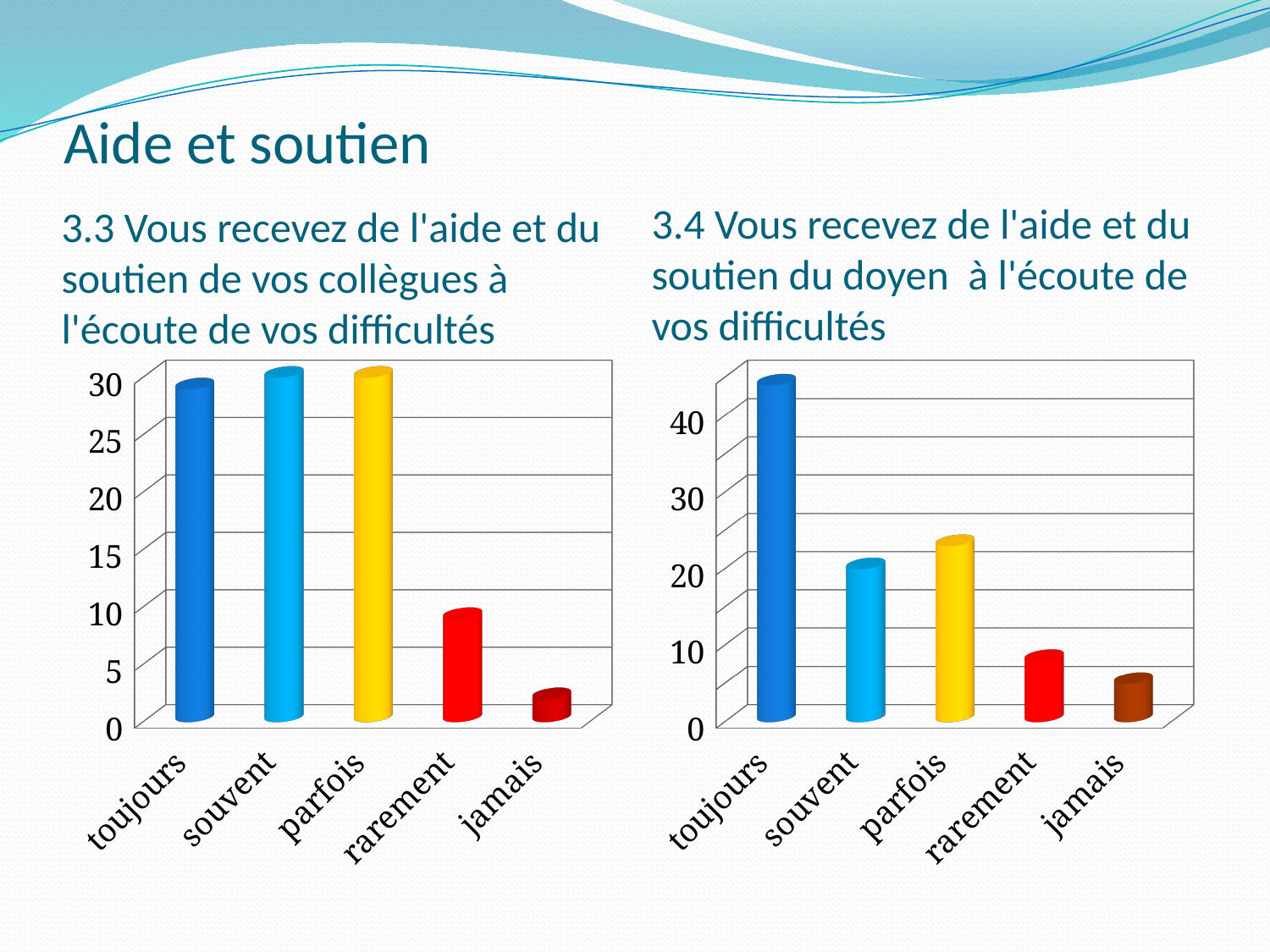
In the chart for question 3.3 on the left, which is larger, the value for rarement or the value for jamais? rarement What kind of chart is used for question 3.3 on the left? bar chart In the chart for question 3.3 on the left, is the value for rarement greater or less than 15? less In the chart for question 3.3 on the left, is the value for toujours greater or less than 25? greater In the chart for question 3.4 on the right, what colour is the bar for toujours? blue In the chart for question 3.4 on the right, which is larger, the value for parfois or the value for rarement? parfois In the chart for question 3.3 on the left, which category has the lowest value? jamais How many categories are shown on the x axis of the chart for question 3.4 on the right? 5 In the chart for question 3.4 on the right, is the value for toujours greater or less than 40? greater In the chart for question 3.4 on the right, which category has the lowest value? jamais In the chart for question 3.4 on the right, which category has the highest value? toujours